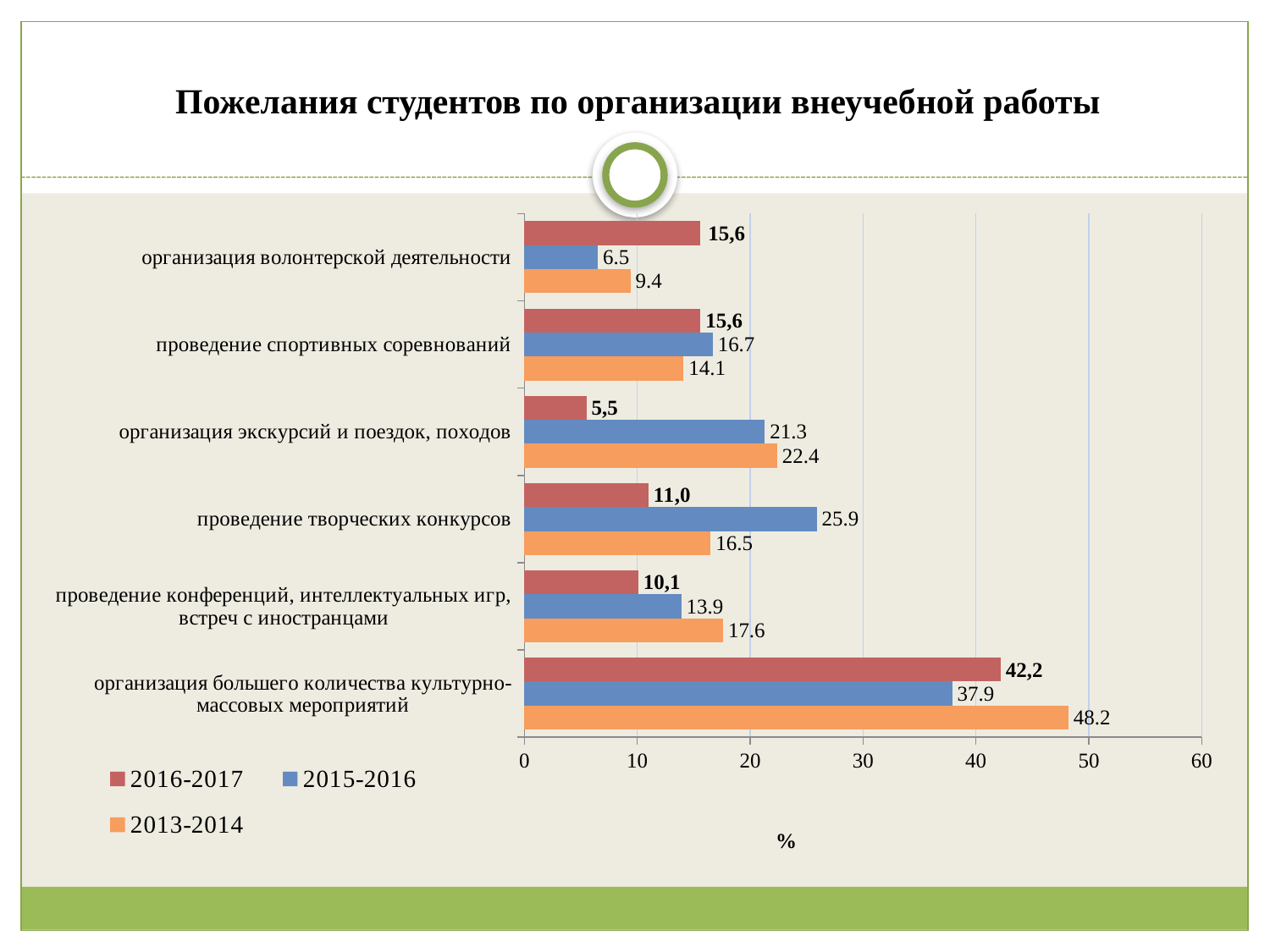
What is the value for 2016-2017 for 'организация большего количества культурно-массовых мероприятий'? 42,2 Which category has the highest value for 2013-2014? организация большего количества культурно-массовых мероприятий Which category has the lowest value for 2015-2016? организация волонтерской деятельности What is the label on the horizontal axis of the chart? % What is the value for 2013-2014 for 'организация экскурсий и поездок, походов'? 22.4 How many series does the legend list? 3 What is the value for 2015-2016 for 'проведение творческих конкурсов'? 25.9 For 'проведение конференций, интеллектуальных игр, встреч с иностранцами', which series has the larger value: 2013-2014 or 2015-2016? 2013-2014 How many categories are shown on the chart? 6 What is the value for 2016-2017 for 'организация экскурсий и поездок, походов'? 5,5 What is the difference between the 2013-2014 and 2015-2016 values for 'организация большего количества культурно-массовых мероприятий'? 10.3 What type of chart is shown on the slide? bar chart